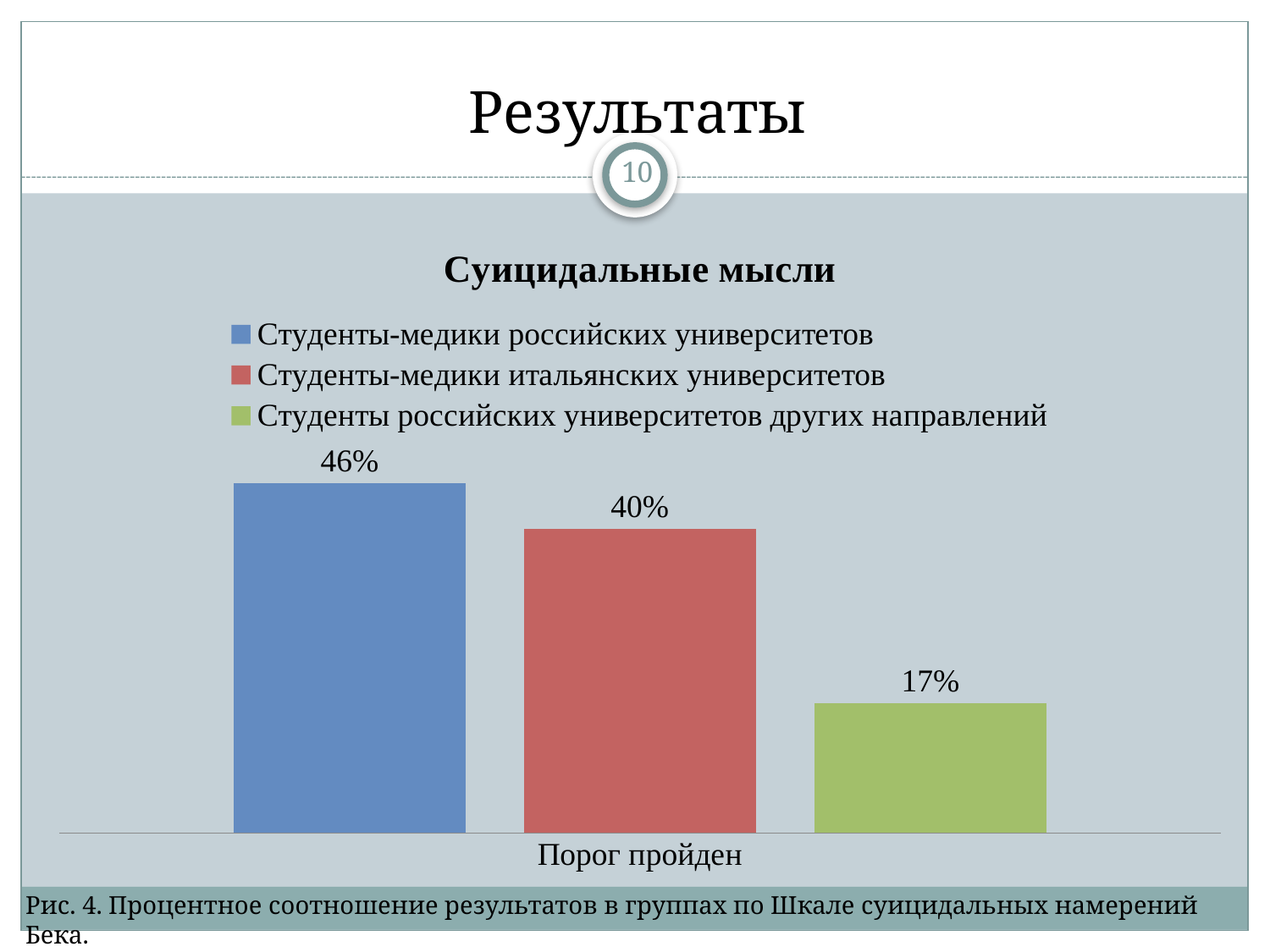
What is the title of the chart? Суицидальные мысли What is the value for Студенты российских университетов других направлений? 17% Which is larger: the value for Студенты-медики итальянских университетов or for Студенты российских университетов других направлений? Студенты-медики итальянских университетов Which series has the lowest value? Студенты российских университетов других направлений What is the difference between the values for Студенты-медики итальянских университетов and Студенты российских университетов других направлений? 23% What is the value for Студенты-медики итальянских университетов? 40% What is the category label on the x axis? Порог пройден How many series does the legend list? 3 What is the value for Студенты-медики российских университетов? 46% What is the difference between the values for Студенты-медики российских университетов and Студенты-медики итальянских университетов? 6% What kind of chart is shown? Bar chart Which series has the highest value? Студенты-медики российских университетов